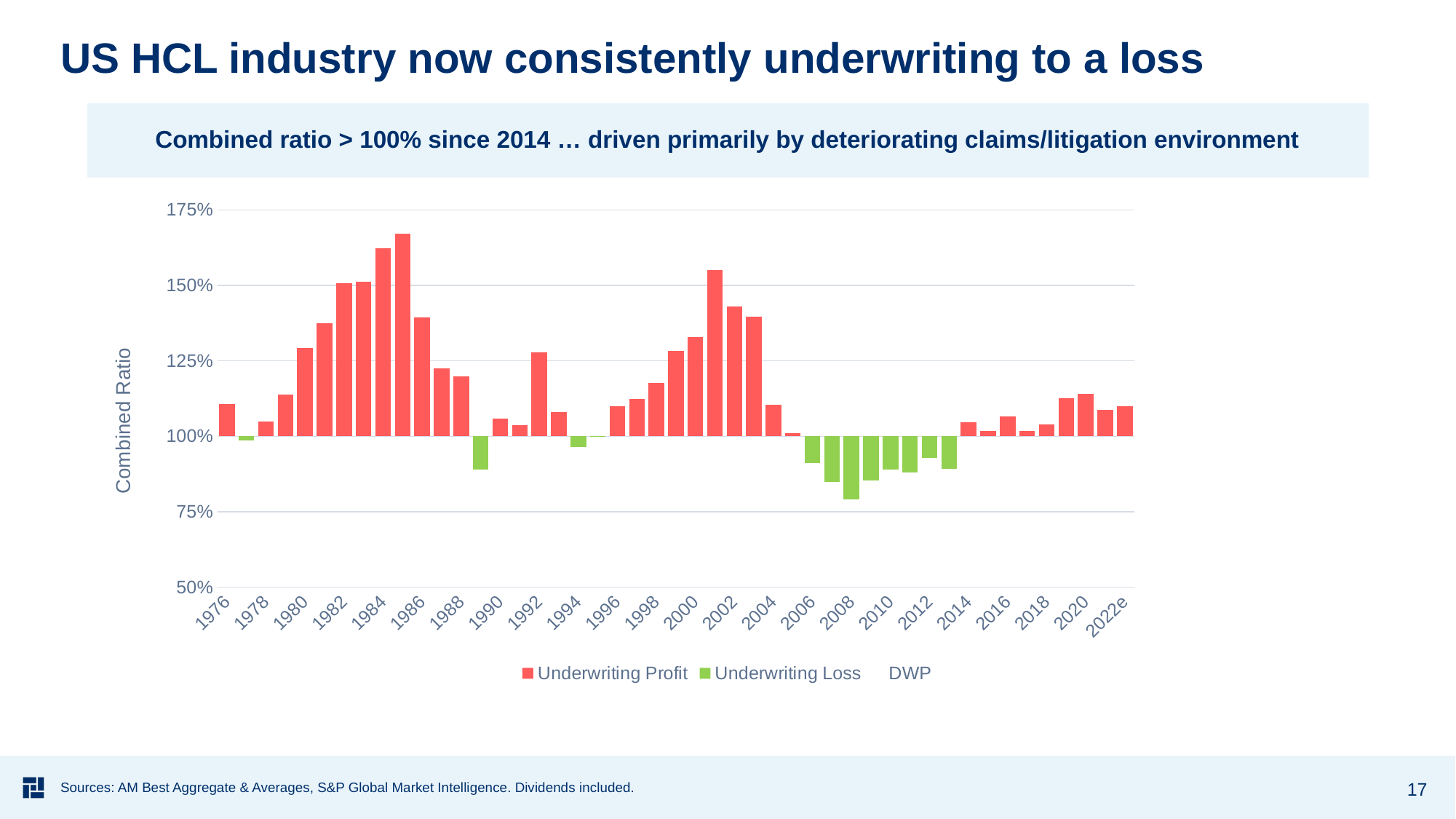
Do the combined ratio values rise or fall from 1980 to 1985? rise How many series does the legend list? 3 Is the combined ratio for 2008 greater or less than 100%? less Is the combined ratio for 2001 greater or less than 150%? greater Which year has the lowest combined ratio? 2008 Which year has the highest combined ratio? 1985 Which year has a higher combined ratio, 1985 or 2001? 1985 Is the combined ratio for 1985 greater or less than 150%? greater Which colour represents Underwriting Loss in the legend? green What is the label on the vertical axis? Combined Ratio What kind of chart is shown on the slide? bar chart